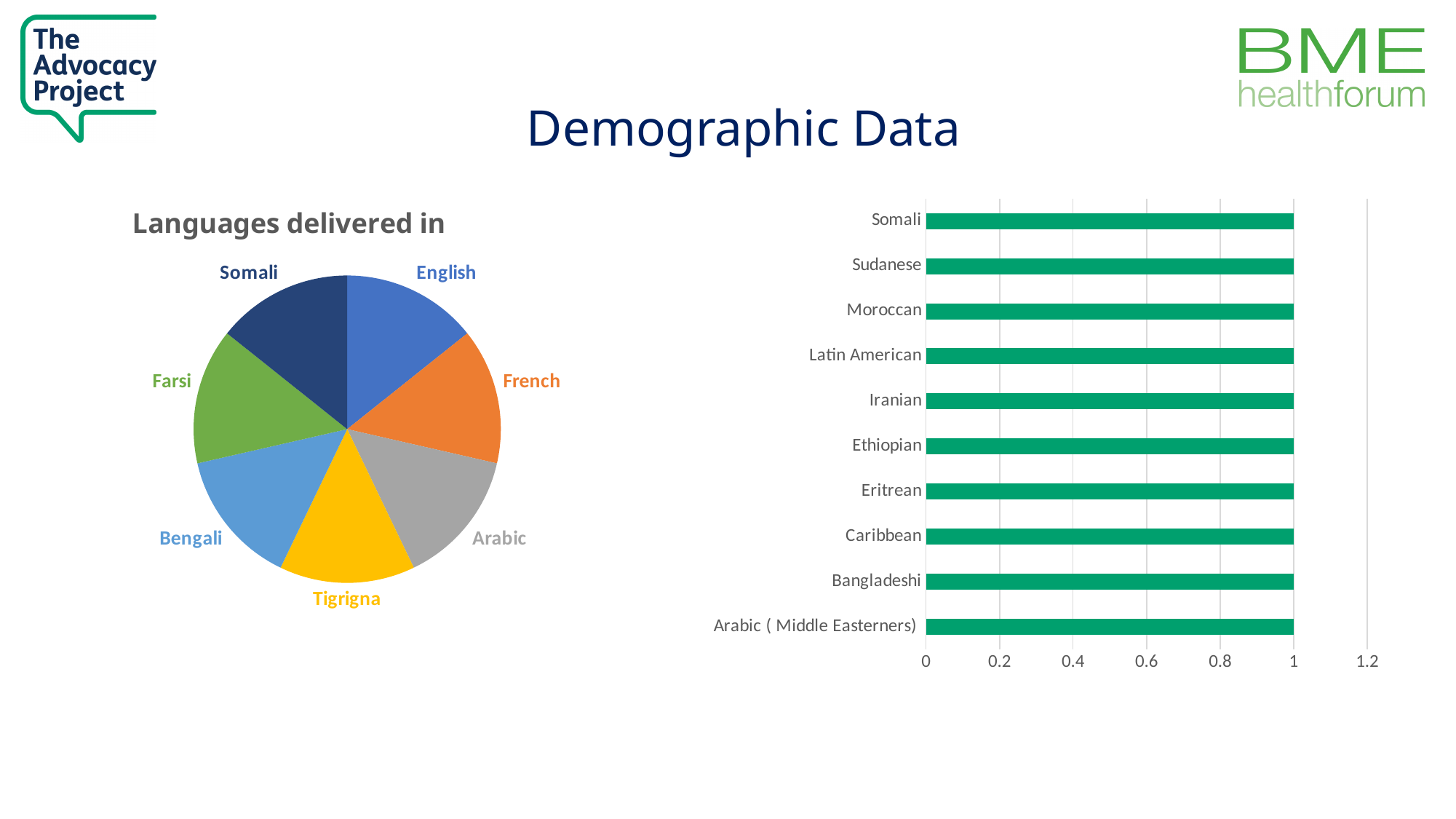
In the bar chart on the right, is the value for Caribbean greater or less than 1.2? less In the bar chart on the right, is the value for Ethiopian greater or less than 0.8? greater How many slices does the pie chart 'Languages delivered in' have? 7 In the bar chart on the right, what is the value for Somali? 1 How many categories are shown in the bar chart on the right? 10 In the bar chart on the right, what is the value for Latin American? 1 What kind of chart is the chart on the right of the slide? bar chart In the bar chart on the right, what is the difference between the values for Sudanese and Iranian? 0 In the pie chart 'Languages delivered in', which slice is coloured yellow? Tigrigna What is the title of the pie chart on the left? Languages delivered in In the bar chart on the right, what is the value for Arabic ( Middle Easterners)? 1 What kind of chart is the chart on the left of the slide? pie chart